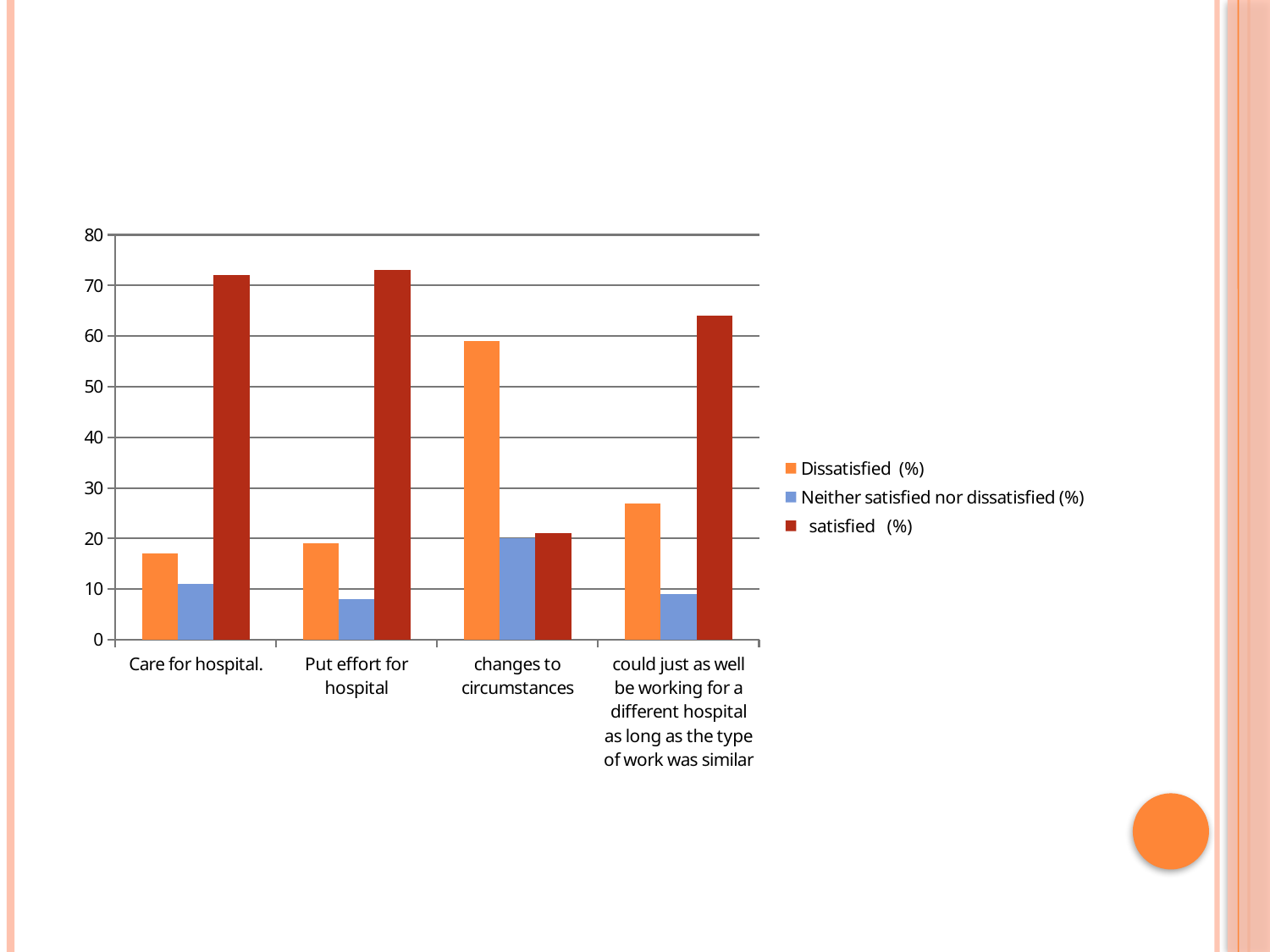
For changes to circumstances, which is larger: the Dissatisfied (%) value or the satisfied (%) value? Dissatisfied (%) Is the Dissatisfied (%) value for changes to circumstances greater or less than 50? greater Is the Dissatisfied (%) value for 'could just as well be working for a different hospital as long as the type of work was similar' greater or less than 20? greater Which colour represents the satisfied (%) series in the legend? dark red How many series does the legend list? 3 What kind of chart is shown on the slide? bar chart Which category has the lowest satisfied (%) value? changes to circumstances Is the Neither satisfied nor dissatisfied (%) value for Care for hospital. greater or less than 20? less Which category has the highest Dissatisfied (%) value? changes to circumstances How many categories are shown on the x axis? 4 Which category has the highest Neither satisfied nor dissatisfied (%) value? changes to circumstances